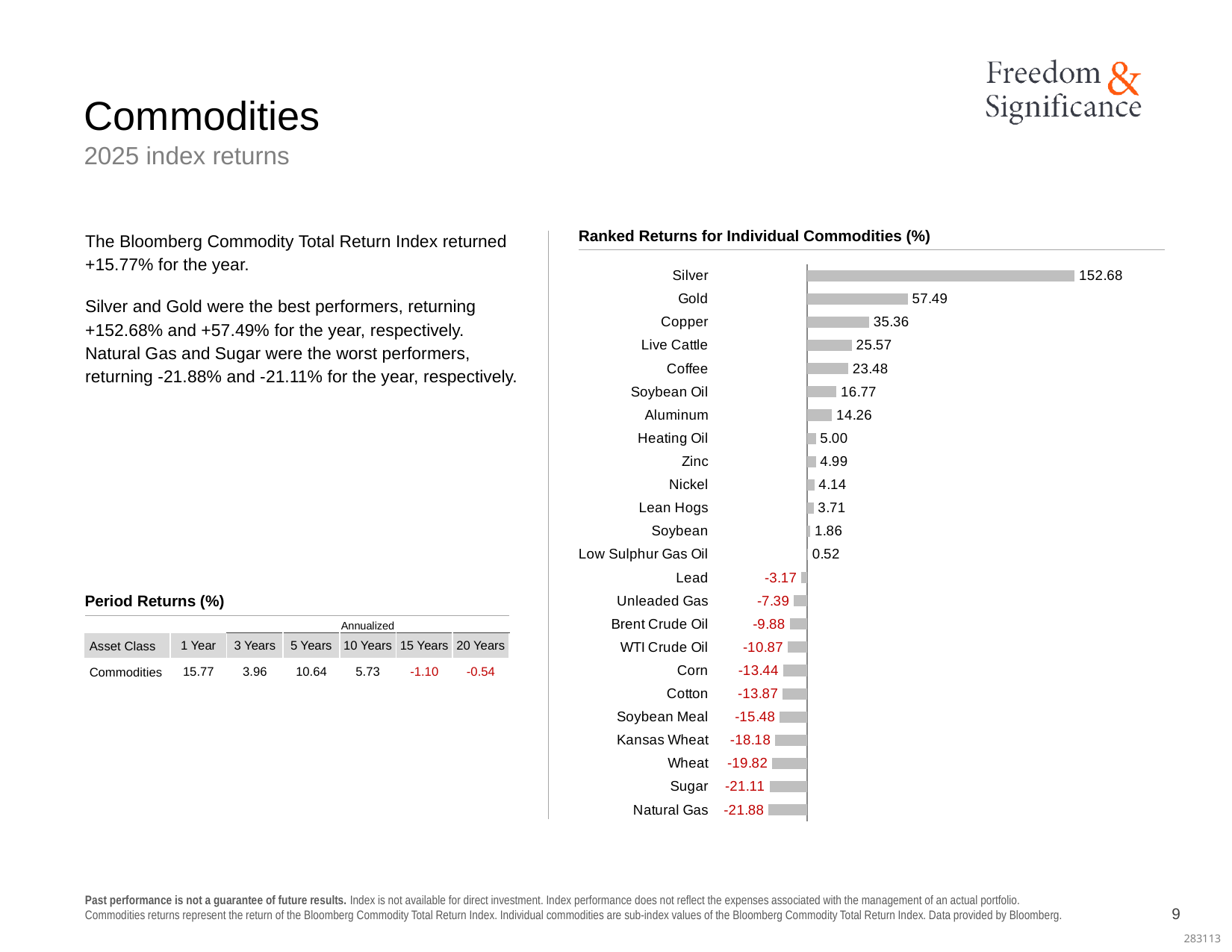
In the Ranked Returns for Individual Commodities chart, which has the larger return, Wheat or Kansas Wheat? Kansas Wheat How many commodities are shown in the Ranked Returns for Individual Commodities chart? 24 What is the return shown for Natural Gas in the Ranked Returns for Individual Commodities chart? -21.88 What is the title of the chart on the slide? Ranked Returns for Individual Commodities (%) What is the return shown for Copper in the Ranked Returns for Individual Commodities chart? 35.36 What is the difference between the returns of Live Cattle and Coffee in the Ranked Returns for Individual Commodities chart? 2.09 What type of chart is the Ranked Returns for Individual Commodities chart? Bar chart What is the difference between the returns of Silver and Gold in the Ranked Returns for Individual Commodities chart? 95.19 In the Ranked Returns for Individual Commodities chart, which has the larger return, Aluminum or Soybean Oil? Soybean Oil Which commodity has the highest return in the Ranked Returns for Individual Commodities chart? Silver Which commodity has the lowest return in the Ranked Returns for Individual Commodities chart? Natural Gas What is the return shown for Low Sulphur Gas Oil in the Ranked Returns for Individual Commodities chart? 0.52